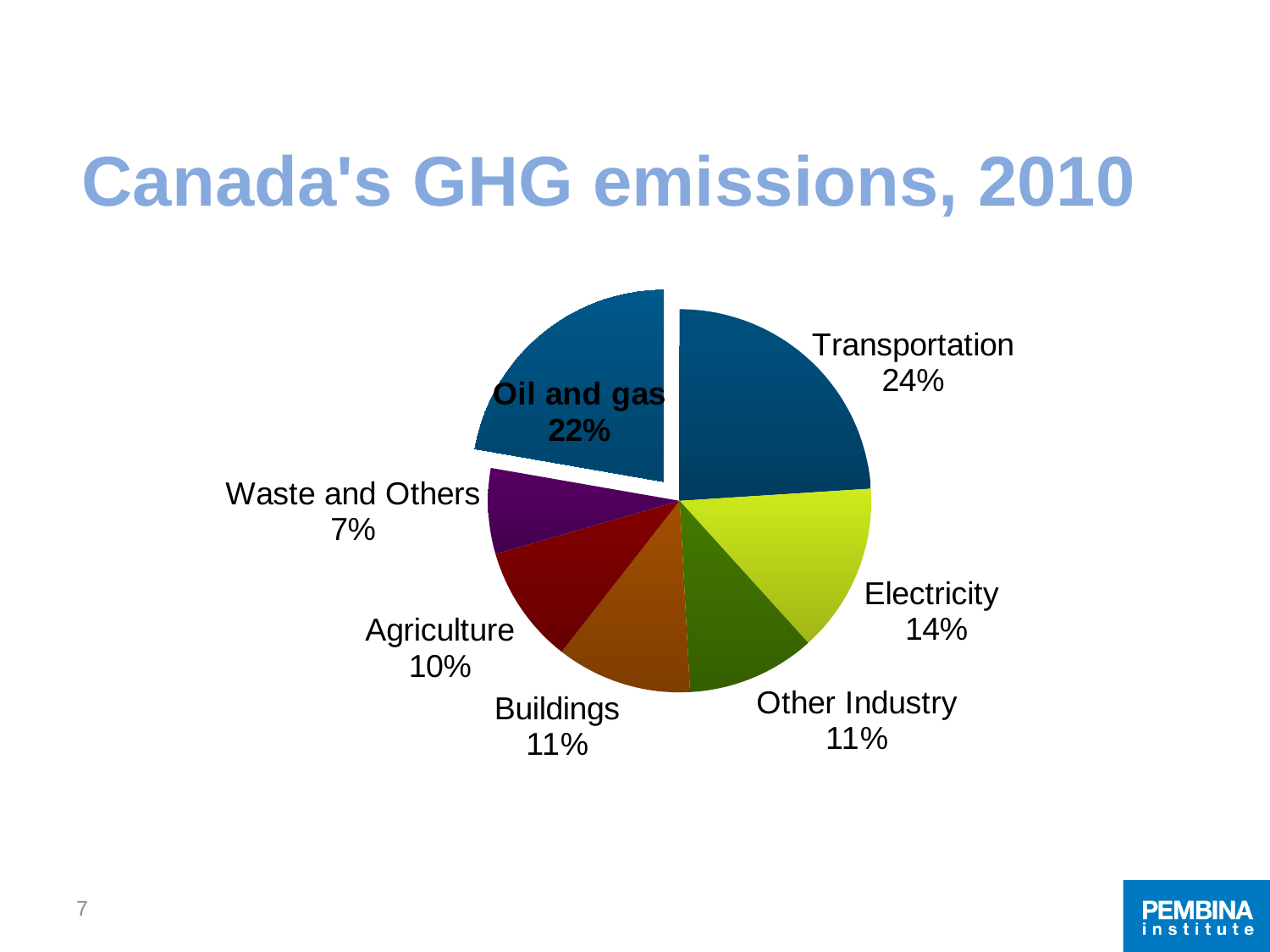
What percentage is shown for Electricity? 14% Which category has the smallest share of the pie? Waste and Others How many categories are shown in the pie chart? 7 What kind of chart is shown on the slide? Pie chart Which is larger, the share for Electricity or the share for Agriculture? Electricity What percentage is shown for Waste and Others? 7% What share of the pie is labelled Oil and gas? 22% How many percentage points larger is the Transportation share than the Electricity share? 10 What is the title of the chart? Canada's GHG emissions, 2010 What is the difference in percentage points between Oil and gas and Agriculture? 12 What share of Canada's GHG emissions in 2010 comes from Transportation? 24% Which category has the largest share of the pie? Transportation